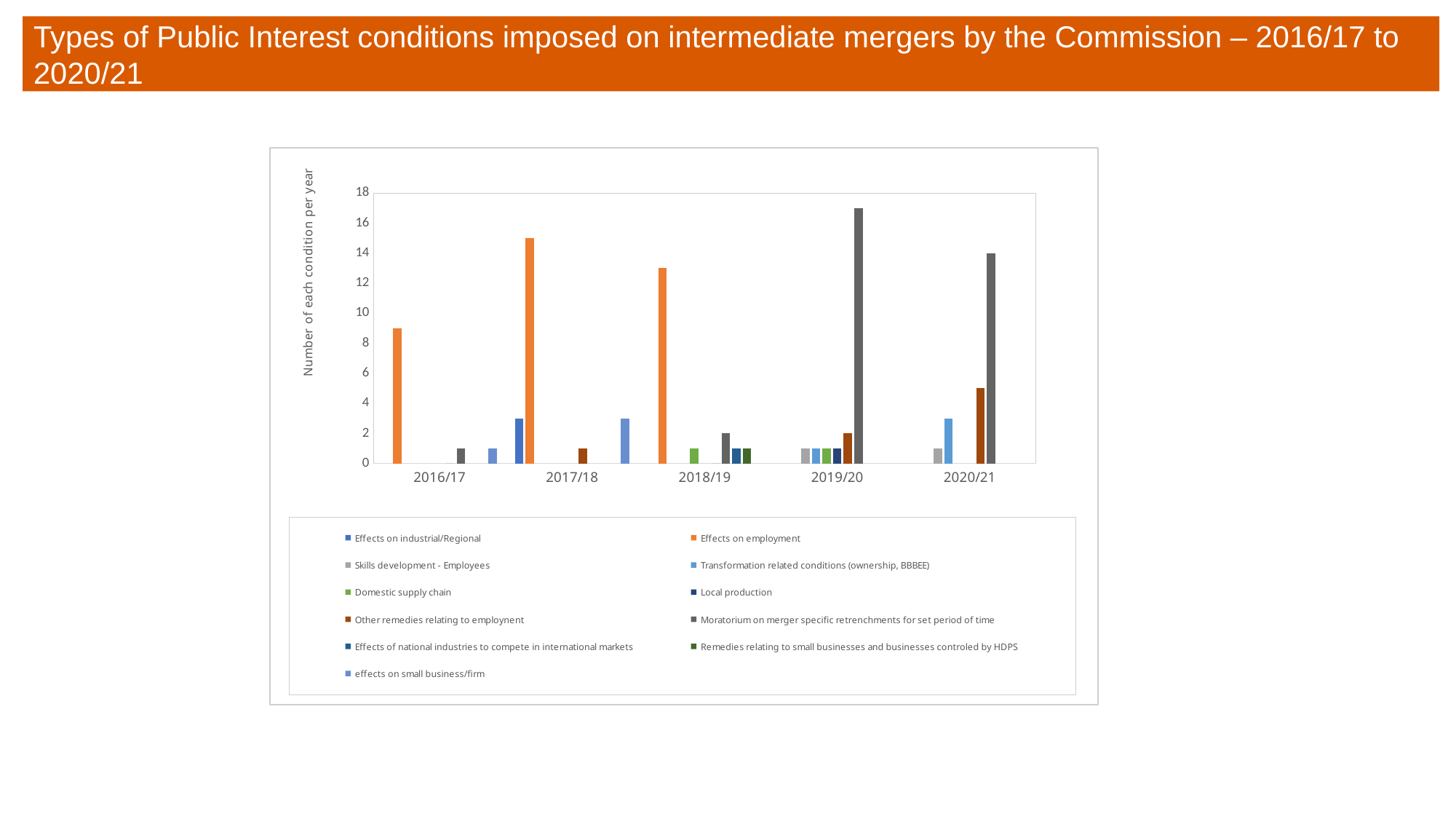
What kind of chart is shown on the slide? bar chart Which series has the tallest bar in 2019/20? Moratorium on merger specific retrenchments for set period of time How many years (categories) are shown on the x axis? 5 Is the value for Moratorium on merger specific retrenchments for set period of time in 2019/20 greater or less than 16? greater What is the value for Moratorium on merger specific retrenchments for set period of time in 2018/19? 2 Is the value for Effects on employment in 2017/18 greater or less than 10? greater Which year contains the tallest bar in the chart? 2019/20 What is the value for Moratorium on merger specific retrenchments for set period of time in 2020/21? 14 What is the title of the y axis? Number of each condition per year Which series has the tallest bar in 2016/17? Effects on employment How many series does the legend list? 11 Which is larger: Effects on employment in 2017/18 or Effects on employment in 2018/19? 2017/18